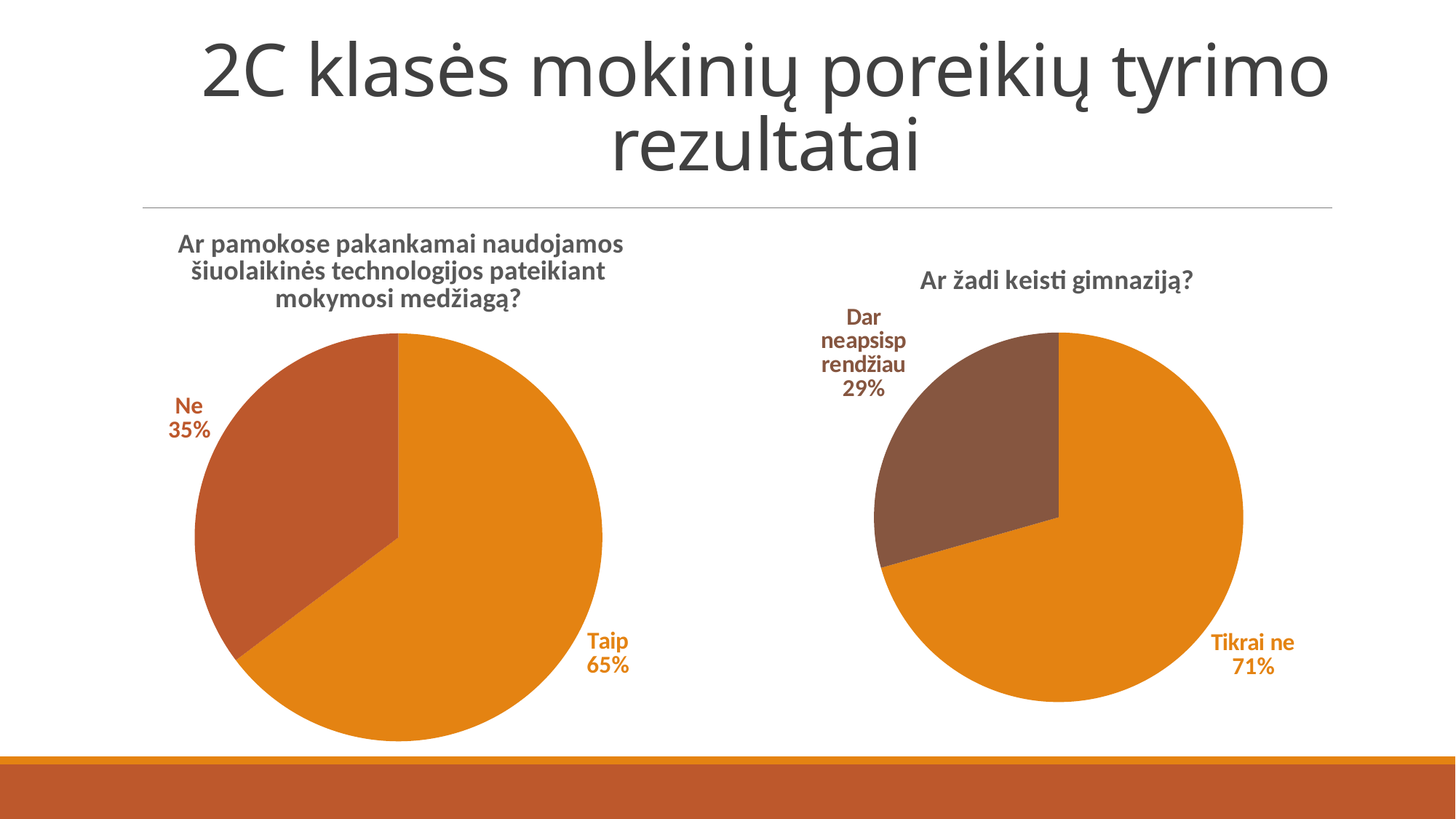
In the left pie chart, what is the difference between the "Taip" and "Ne" shares? 30% Which is larger: the "Taip" share in the left pie chart or the "Tikrai ne" share in the right pie chart? Tikrai ne In the right pie chart, what share is labelled "Dar neapsisprendžiau"? 29% What is the title of the chart on the right side of the slide? Ar žadi keisti gimnaziją? What type of chart is used on the left side of the slide? Pie chart In the left pie chart ("Ar pamokose pakankamai naudojamos šiuolaikinės technologijos pateikiant mokymosi medžiagą?"), what share is labelled "Taip"? 65% In the right pie chart, which slice is the smallest? Dar neapsisprendžiau In the left pie chart, which slice is the largest? Taip In the right pie chart ("Ar žadi keisti gimnaziją?"), what share is labelled "Tikrai ne"? 71% In the right pie chart, what is the difference between the "Tikrai ne" and "Dar neapsisprendžiau" shares? 42% How many slices does the right pie chart have? 2 In the left pie chart, what share is labelled "Ne"? 35%